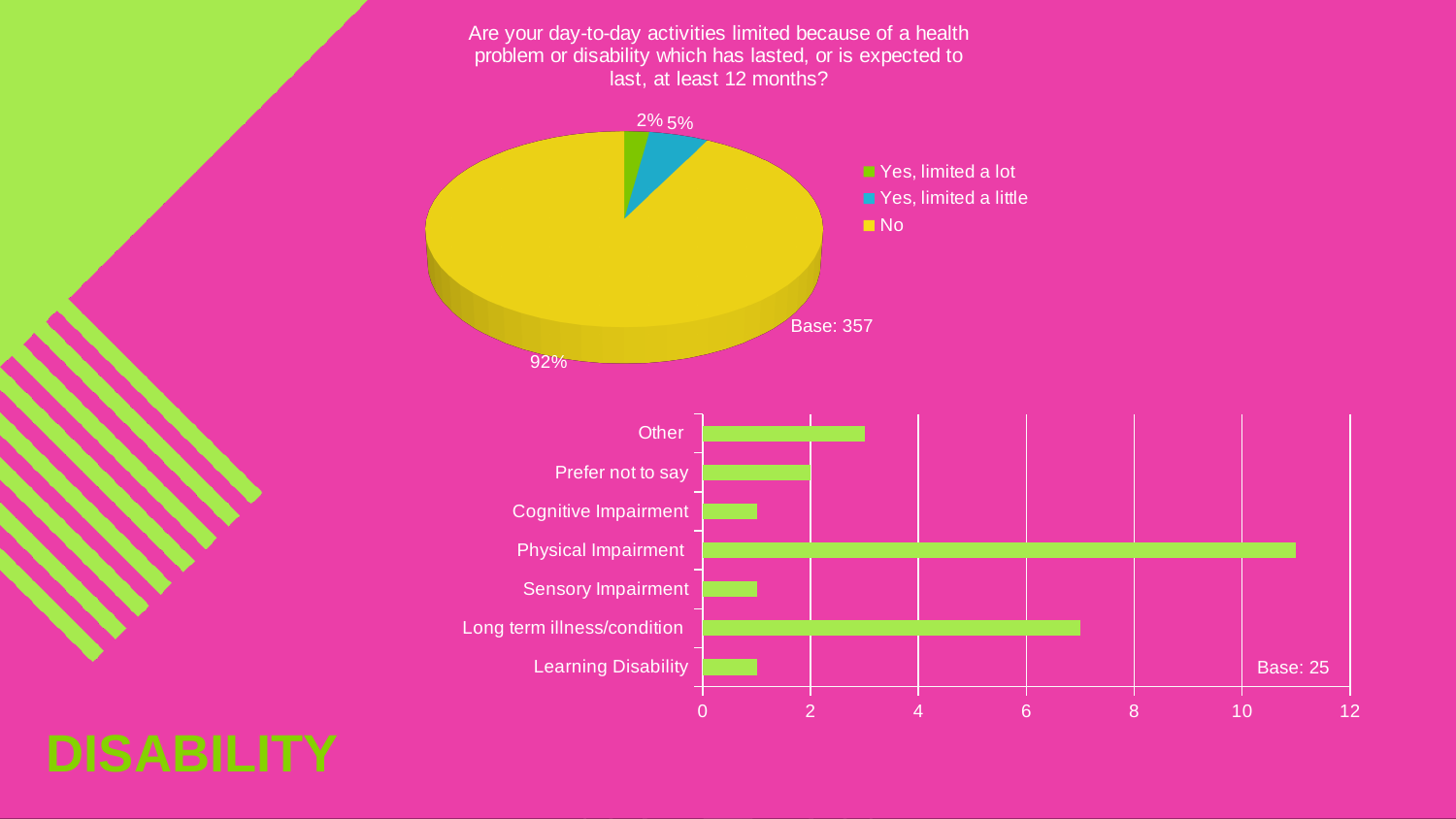
In the lower bar chart, which category has the highest value? Physical Impairment In the pie chart, what percentage of respondents answered "Yes, limited a lot"? 2% In the pie chart, which response has the largest share? No In the pie chart, which response has the smallest share? Yes, limited a lot What is the base (number of respondents) shown for the pie chart? Base: 357 In the pie chart, what is the difference in percentage points between "Yes, limited a little" and "Yes, limited a lot"? 3 What type of chart is the lower chart on the slide? Bar chart In the lower bar chart, how many categories are shown? 7 In the pie chart, what percentage of respondents answered "No"? 92% How many entries does the legend of the pie chart list? 3 In the lower bar chart, is the value for Long term illness/condition greater or less than 6? greater In the pie chart, what percentage of respondents answered "Yes, limited a little"? 5%